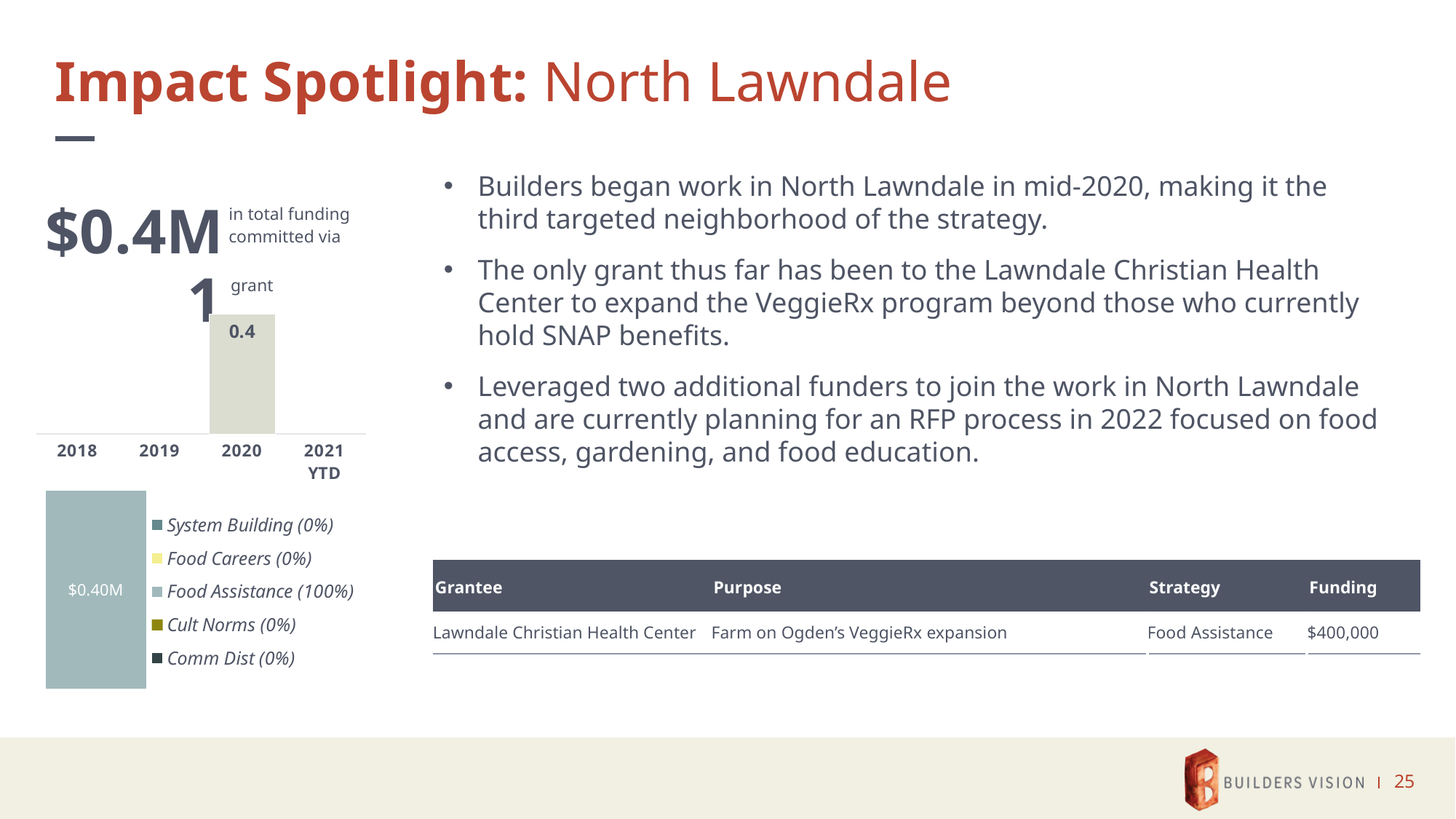
In the bar chart by year, what is the value shown for 2020? 0.4 In the stacked bar chart at the bottom left, what percentage is shown for System Building in the legend? 0% In the bar chart by year, which year has the highest value? 2020 In the stacked bar chart at the bottom left, which strategy accounts for the entire bar? Food Assistance What is the total funding figure shown above the bar chart by year? $0.4M In the stacked bar chart at the bottom left, what percentage is shown for Food Assistance in the legend? 100% How many grants does the text above the bar chart by year say the funding was committed via? 1 How many year categories are shown on the x axis of the bar chart by year? 4 In the bar chart by year, is the value for 2020 larger than the value for 2019? Yes In the stacked bar chart at the bottom left, what value is labeled on the bar? $0.40M What kind of chart is the chart by year on the left of the slide? bar chart How many series does the legend of the stacked bar chart at the bottom left list? 5